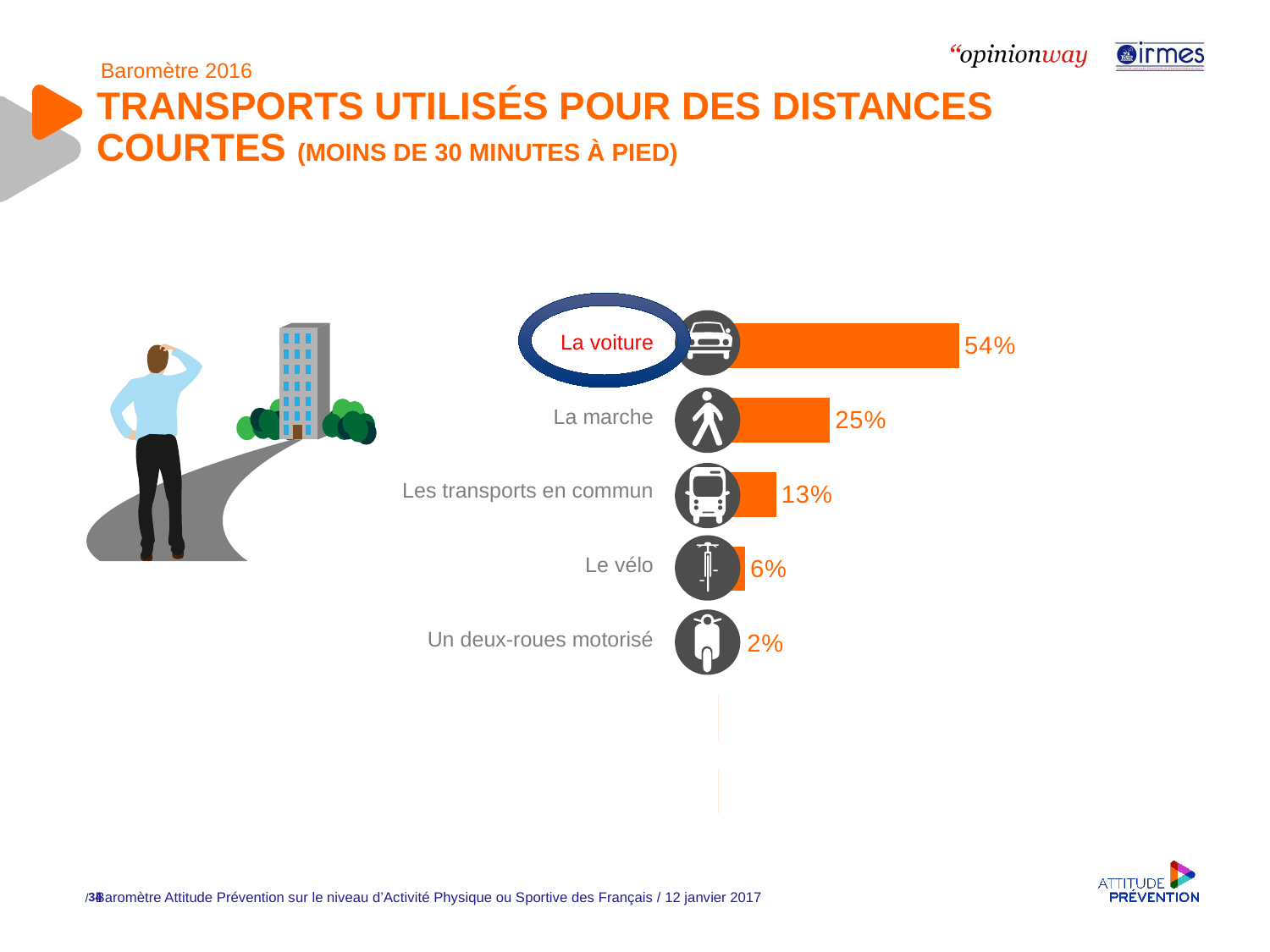
What percentage is shown for La marche? 25% Which mode of transport has the lowest percentage? Un deux-roues motorisé What percentage is shown for La voiture? 54% What is the difference in percentage points between La voiture and La marche? 29 How many modes of transport are shown in the chart? 5 Which mode of transport has the highest percentage? La voiture Which category label is circled in blue on the chart? La voiture What percentage is shown for Un deux-roues motorisé? 2% What type of chart is shown on the slide? Bar chart What percentage is shown for Les transports en commun? 13% What percentage is shown for Le vélo? 6% Which is larger, the value for Les transports en commun or the value for Le vélo? Les transports en commun